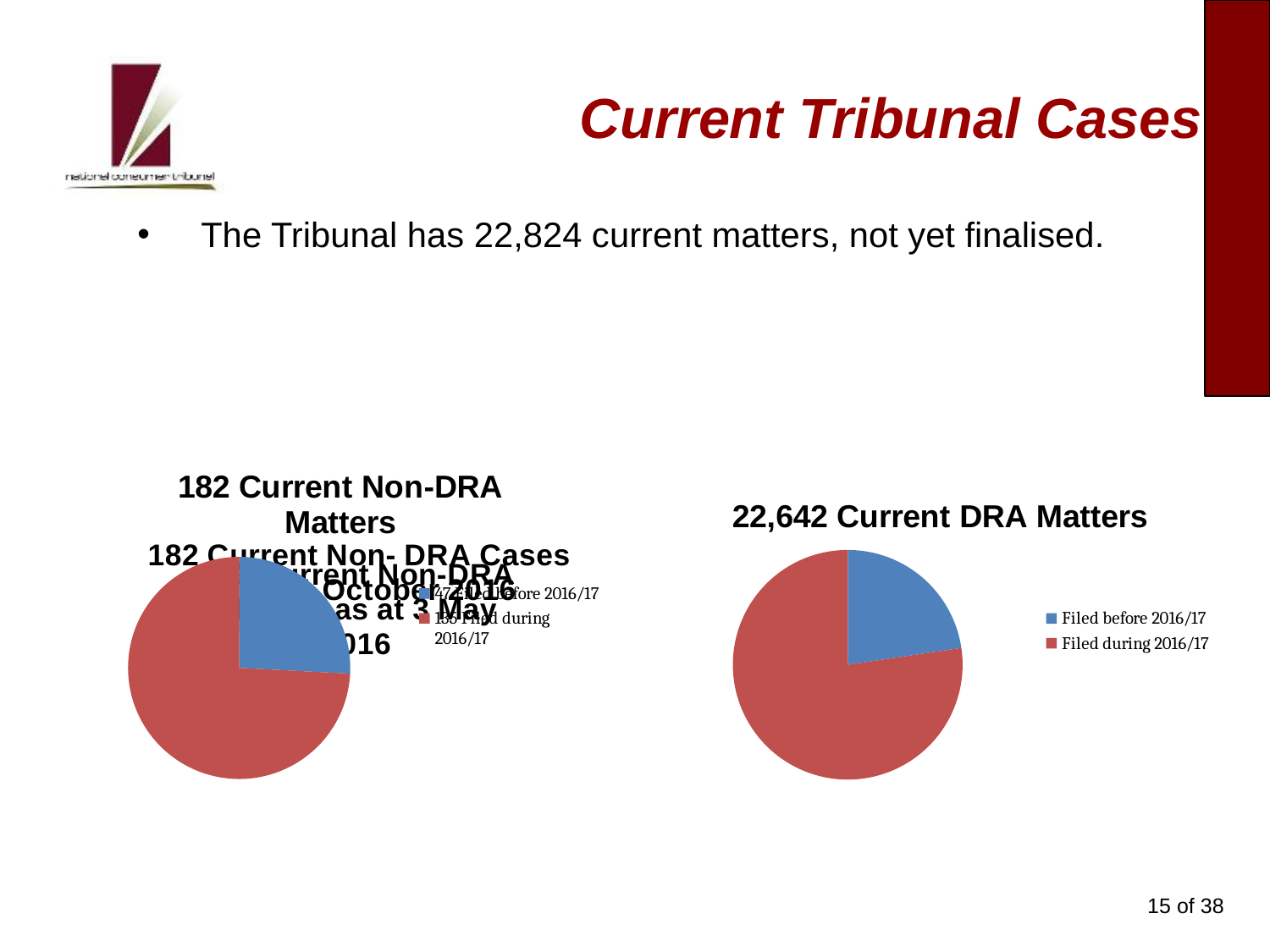
What kind of chart is the '22,642 Current DRA Matters' chart? pie chart In the '22,642 Current DRA Matters' chart, how many slices does the pie have? 2 In the '182 Current Non-DRA Matters' chart on the left, how many slices does the pie have? 2 In the '22,642 Current DRA Matters' chart, which slice is larger: 'Filed before 2016/17' or 'Filed during 2016/17'? Filed during 2016/17 What is the title of the pie chart on the right of the slide? 22,642 Current DRA Matters In the '22,642 Current DRA Matters' chart, which category has the smallest slice? Filed before 2016/17 In the '22,642 Current DRA Matters' chart, what colour is the 'Filed during 2016/17' slice? red What kind of chart is the '182 Current Non-DRA Matters' chart on the left? pie chart In the '22,642 Current DRA Matters' chart, which category has the largest slice? Filed during 2016/17 In the '22,642 Current DRA Matters' chart, how many entries does the legend list? 2